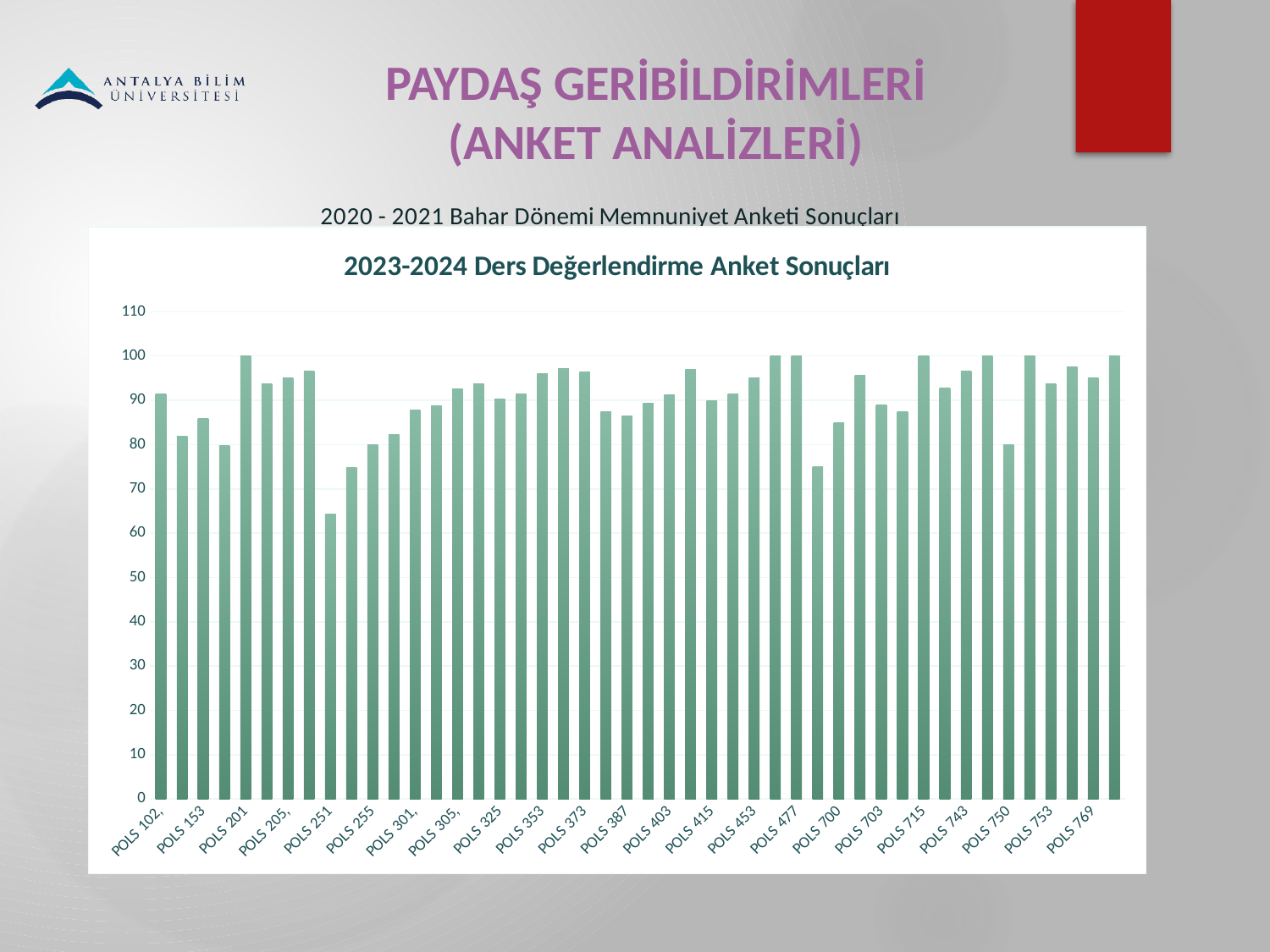
Is the value for POLS 201 greater or less than 90? greater What kind of chart is shown on the slide? bar chart What is the highest value shown on the vertical axis of the chart? 110 Which is larger, the value for POLS 201 or the value for POLS 251? POLS 201 Is the value for POLS 715 greater or less than 90? greater Is the value for POLS 251 greater or less than 70? less What is the title of the chart? 2023-2024 Ders Değerlendirme Anket Sonuçları Which course has the lowest bar in the chart? POLS 251 Which is larger, the value for POLS 153 or the value for POLS 251? POLS 153